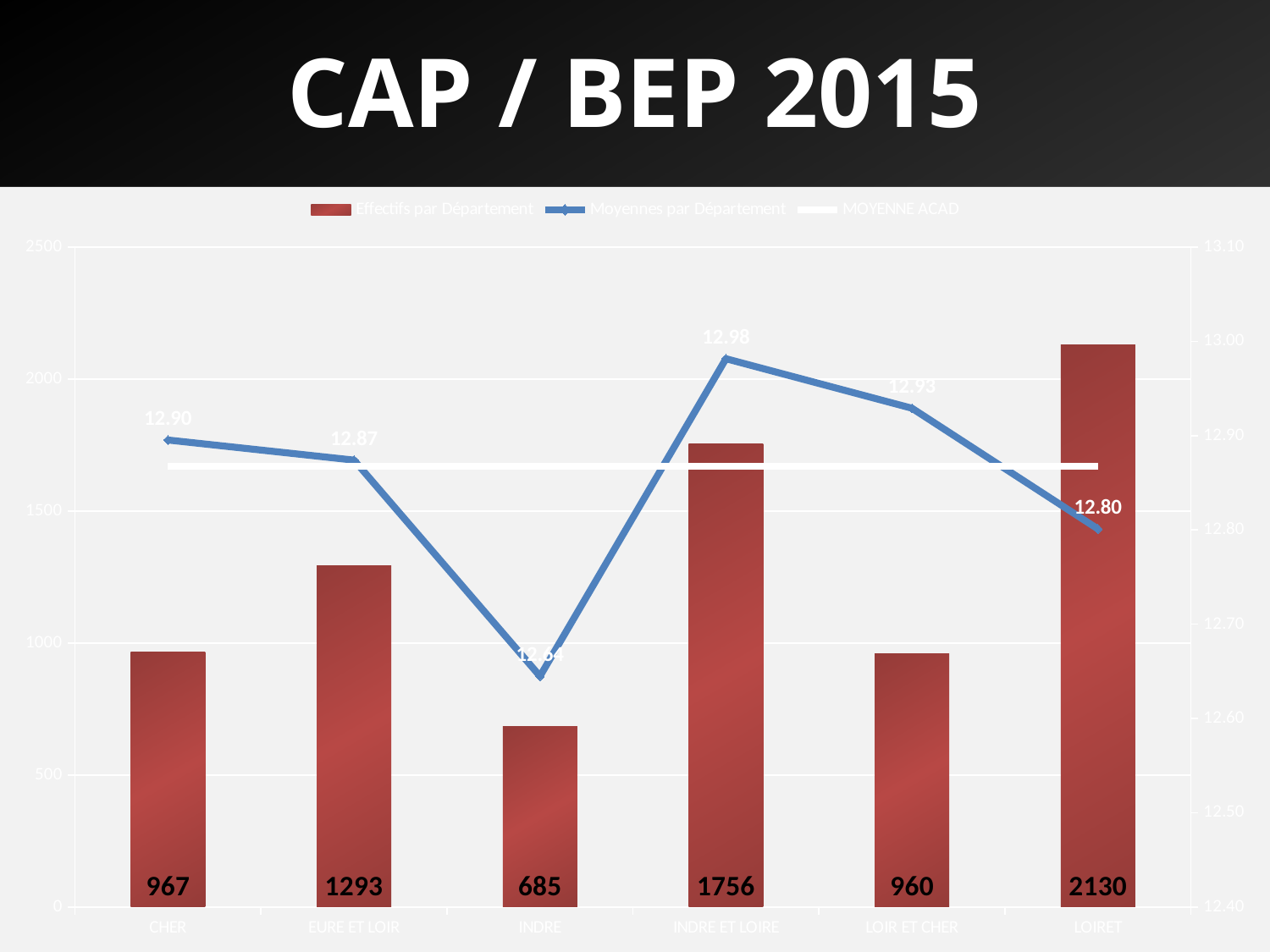
Which has a larger Effectifs par Département, CHER or LOIR ET CHER? CHER What is the Moyennes par Département value for CHER? 12.90 What is the Moyennes par Département value for INDRE ET LOIRE? 12.98 What is the title of the slide? CAP / BEP 2015 How many series does the legend list? 3 Which department has the highest Effectifs par Département? LOIRET What is the value of Effectifs par Département for LOIRET? 2130 Which department has the lowest Moyennes par Département? INDRE How many departments are shown on the x axis? 6 Is the Effectifs par Département value for INDRE ET LOIRE greater or less than 1500? greater What is the difference in Effectifs par Département between LOIRET and INDRE? 1445 What is the value of Effectifs par Département for INDRE? 685